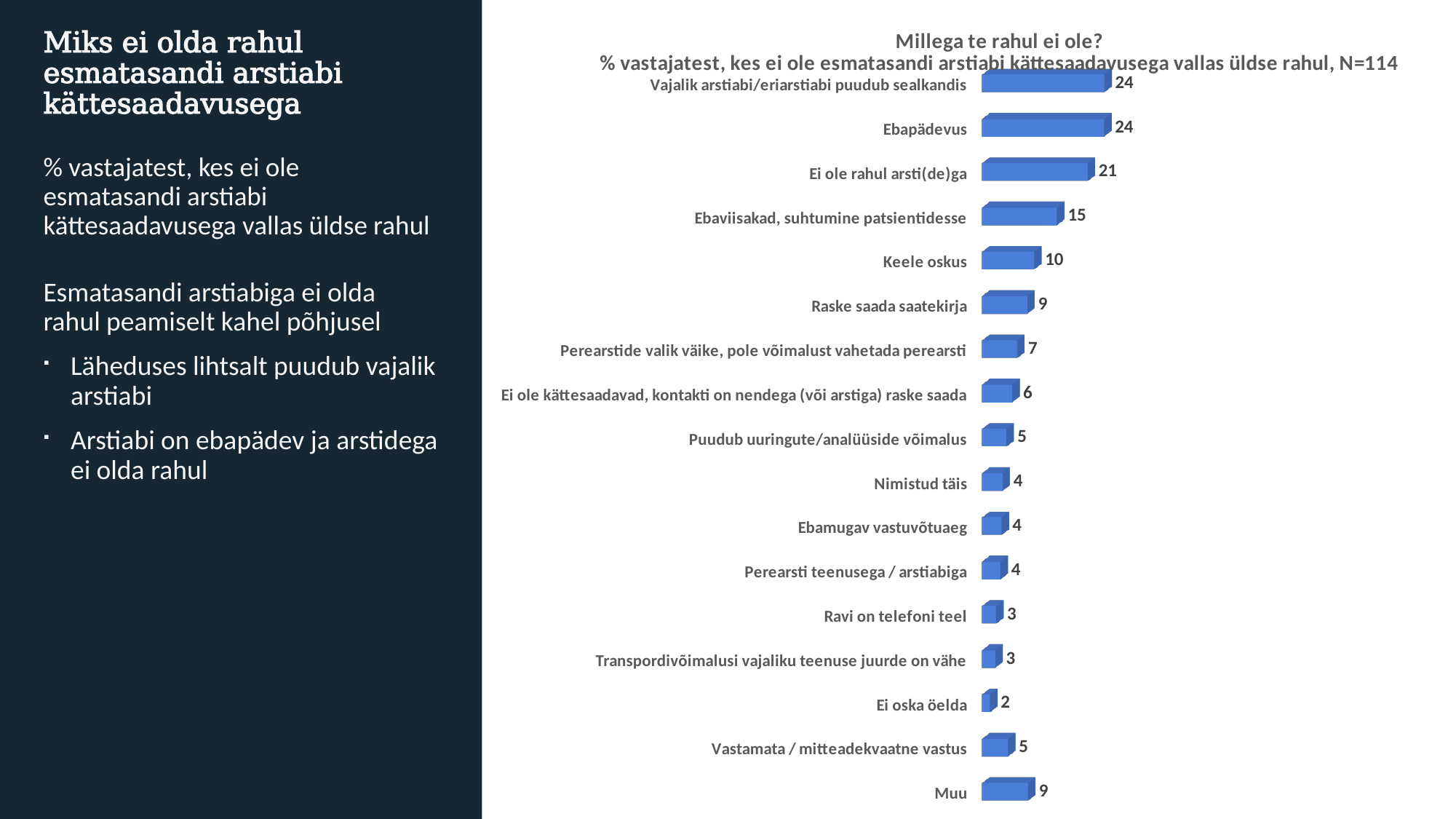
What is the N stated in the chart title? N=114 What kind of chart is shown on the slide? bar chart What is the value for "Muu"? 9 What is the difference between the values for "Keele oskus" and "Raske saada saatekirja"? 1 What is the difference between the values for "Ebapädevus" and "Ei ole rahul arsti(de)ga"? 3 Which is larger, the value for "Vastamata / mitteadekvaatne vastus" or the value for "Ei oska öelda"? Vastamata / mitteadekvaatne vastus What is the value for "Ebaviisakad, suhtumine patsientidesse"? 15 What is the value for "Ei ole rahul arsti(de)ga"? 21 Which is larger, the value for "Ebaviisakad, suhtumine patsientidesse" or the value for "Keele oskus"? Ebaviisakad, suhtumine patsientidesse What is the value for "Keele oskus"? 10 How many categories are shown in the chart? 17 Which category has the lowest value? Ei oska öelda